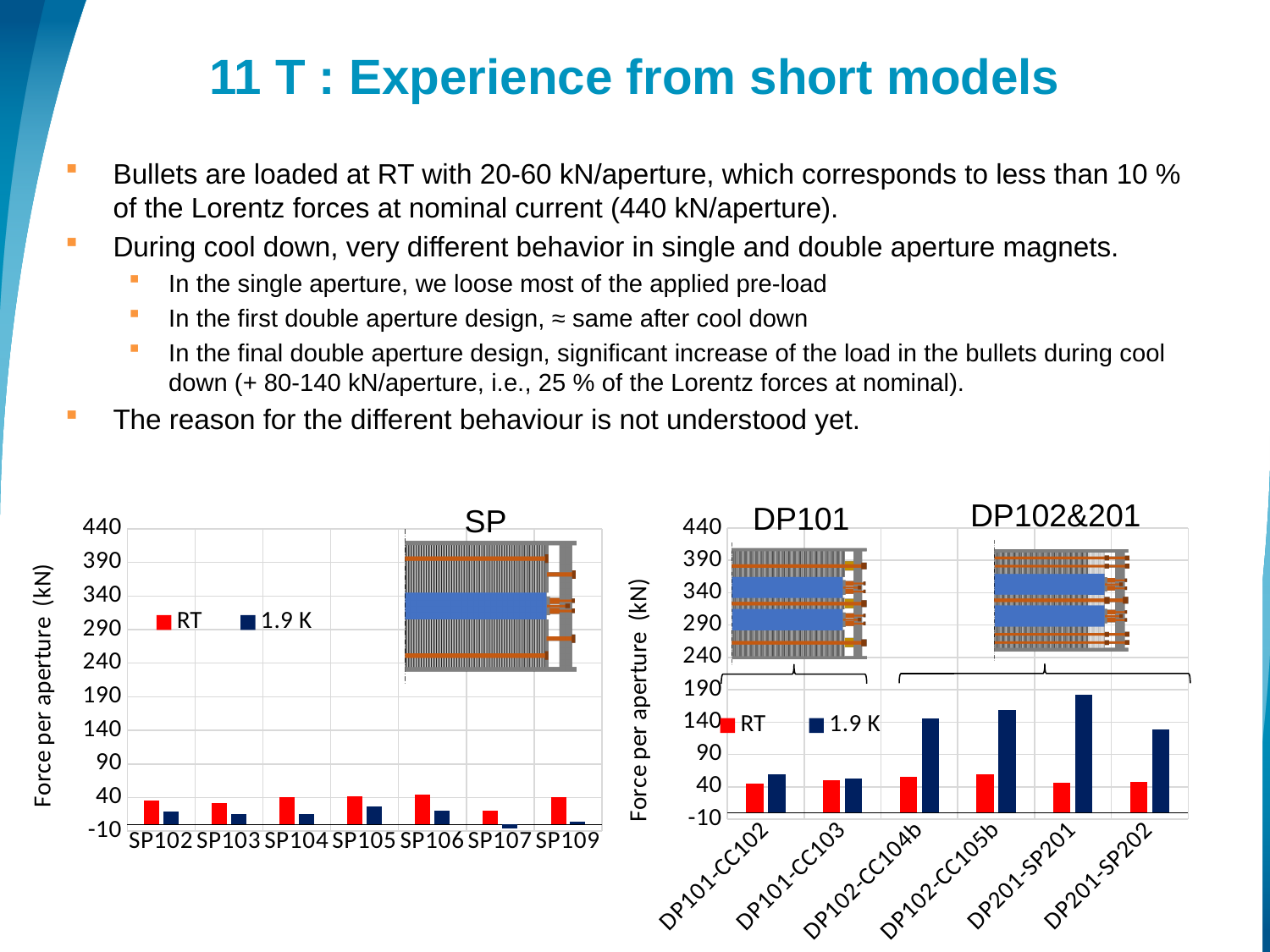
In the right-hand chart, what colour are the 1.9 K bars? dark blue How many series does the legend of the SP chart on the left list? 2 What is the y-axis label of the SP chart on the left? Force per aperture (kN) In the SP chart on the left, which category has the lowest RT value? SP107 In the SP chart on the left, is the RT value for SP106 greater or less than 90? less What kind of chart is the SP chart on the left? bar chart How many categories are shown on the x axis of the SP chart on the left? 7 In the SP chart on the left, which is larger for SP102: the RT value or the 1.9 K value? RT In the right-hand chart, is the 1.9 K value for DP201-SP201 greater or less than 140? greater In the right-hand chart, which is larger for DP201-SP201: the RT value or the 1.9 K value? 1.9 K How many categories are shown on the x axis of the right-hand chart (DP101 / DP102&201)? 6 In the right-hand chart (DP101 / DP102&201), which category has the highest 1.9 K value? DP201-SP201